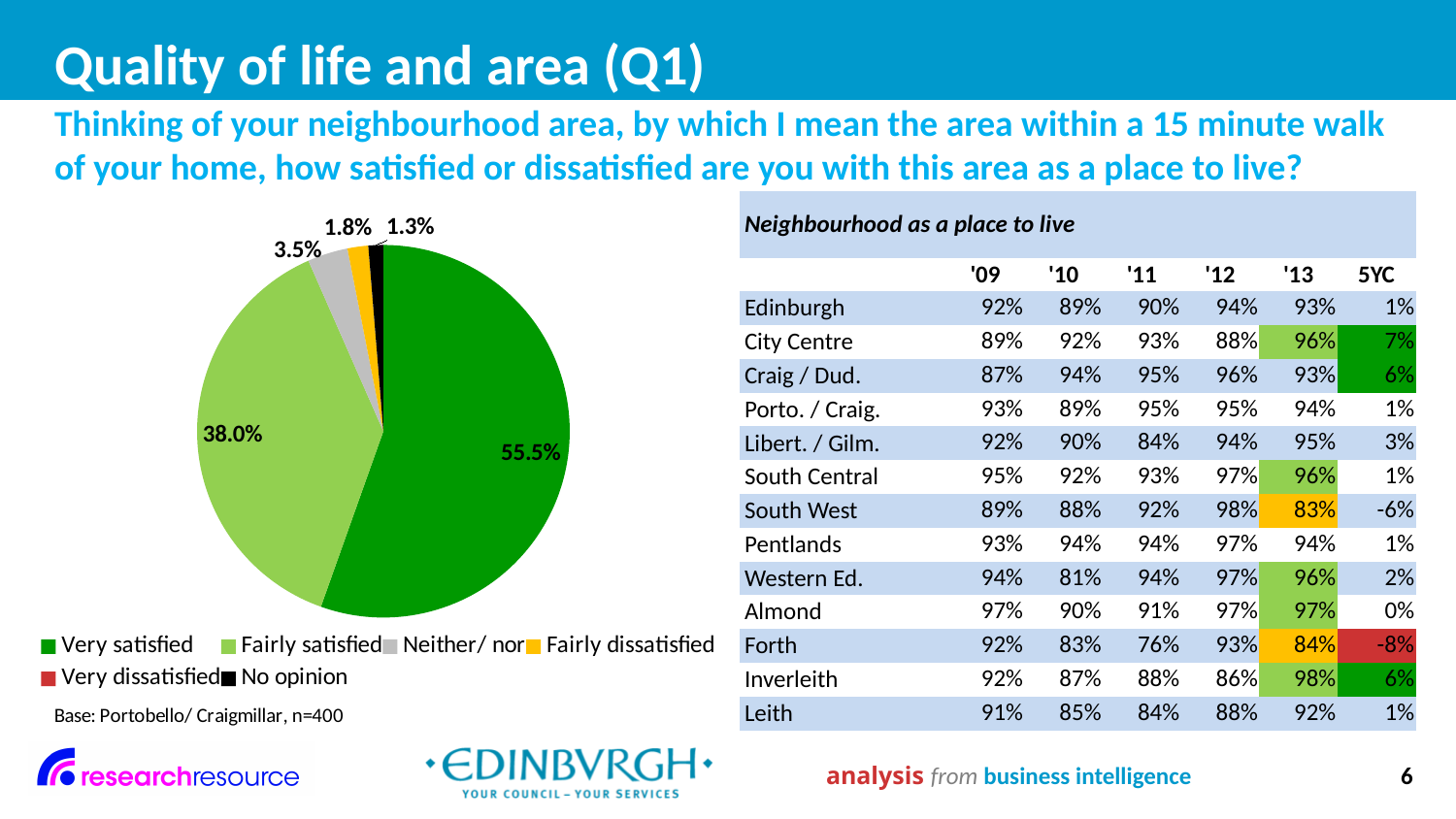
Which response category has the largest slice of the pie? Very satisfied What share of the pie is labelled Neither/ nor? 3.5% What colour is the Very satisfied slice of the pie? dark green What percentage of respondents are fairly satisfied? 38.0% What kind of chart is shown on the slide? pie chart Which is larger, the Very satisfied slice or the Fairly satisfied slice? Very satisfied What is the difference in percentage points between the Very satisfied and Fairly satisfied slices? 17.5 What is the combined percentage of Very satisfied and Fairly satisfied respondents? 93.5% What is the base (sample size) stated for the pie chart? Portobello/ Craigmillar, n=400 What percentage of respondents are fairly dissatisfied? 1.8% What percentage of respondents are very satisfied with their area as a place to live? 55.5% How many response categories does the pie chart legend list? 6